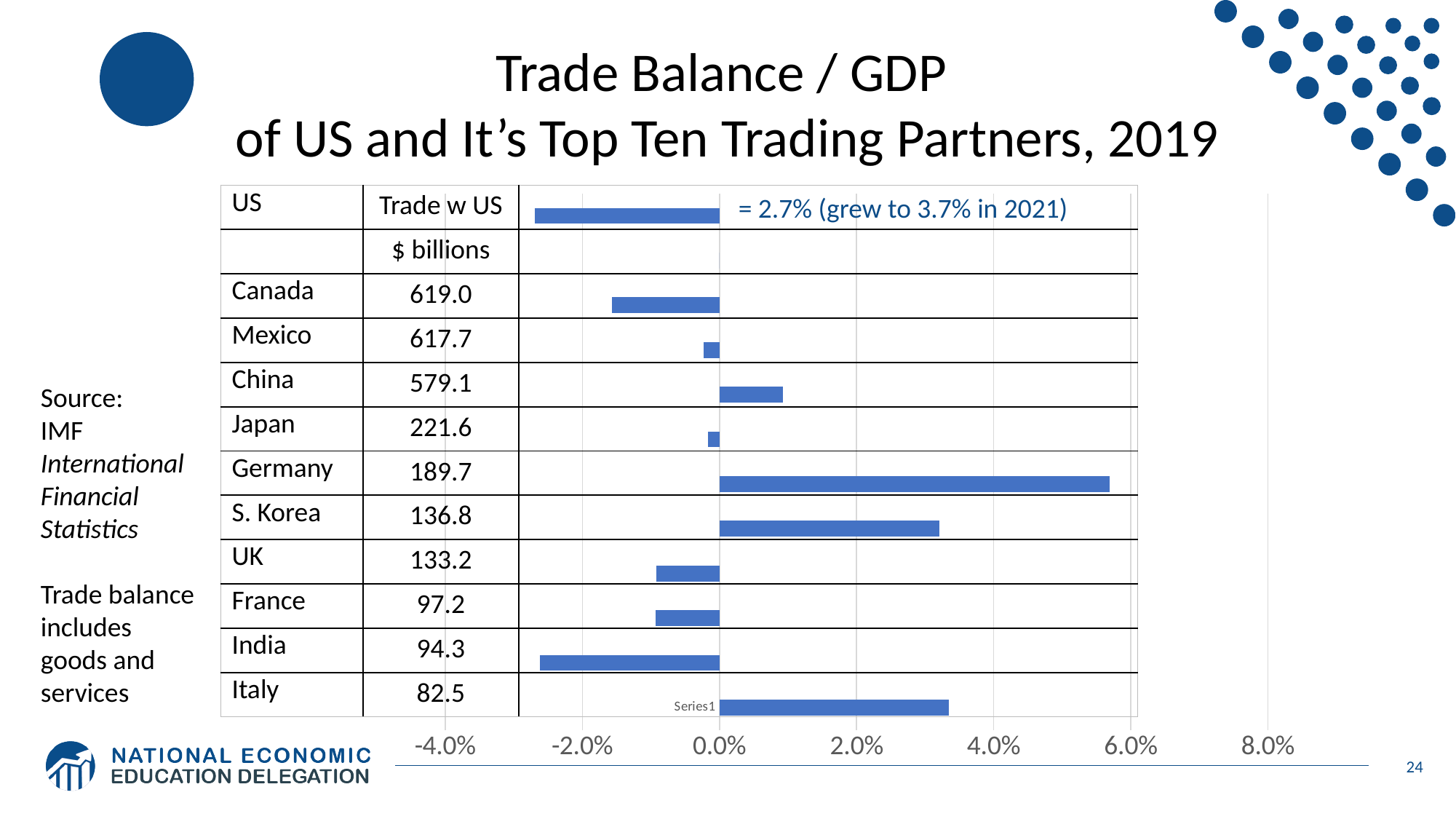
Is the trade balance / GDP value for China greater or less than 2.0%? less Is the trade balance / GDP value for Germany greater or less than 4.0%? greater Which country has the highest trade balance / GDP in the chart? Germany What kind of chart is shown on the slide? bar chart What trade balance / GDP value is annotated for the US bar in the chart? 2.7% Which has the larger trade balance / GDP, Italy or China? Italy How many countries (including the US) have bars plotted in the chart? 11 Is the trade balance / GDP value for S. Korea greater or less than 2.0%? greater What is the title of the chart on the slide? Trade Balance / GDP of US and It's Top Ten Trading Partners, 2019 Which has the larger trade balance / GDP, Germany or S. Korea? Germany